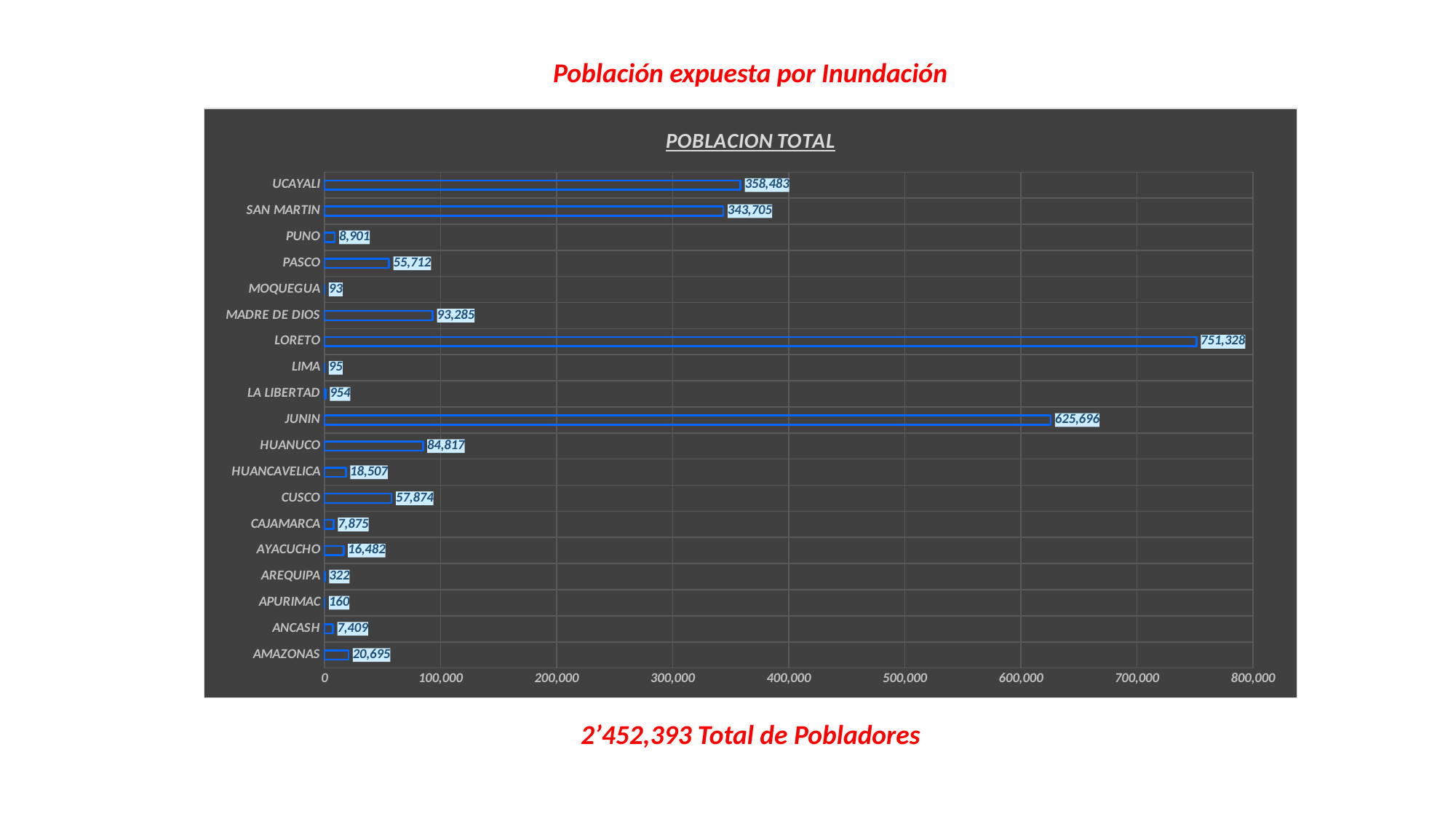
What is the difference between the values for LORETO and JUNIN? 125,632 Is the value for JUNIN greater or less than 600,000? greater What is the difference between the values for UCAYALI and SAN MARTIN? 14,778 Which is larger, the value for JUNIN or the value for UCAYALI? JUNIN What is the value for MADRE DE DIOS? 93,285 What is the value for LORETO? 751,328 What is the value for AMAZONAS? 20,695 Which category has the highest value? LORETO What is the title of the chart? POBLACION TOTAL What kind of chart is shown on the slide? bar chart What is the value for SAN MARTIN? 343,705 How many categories are shown on the chart? 19